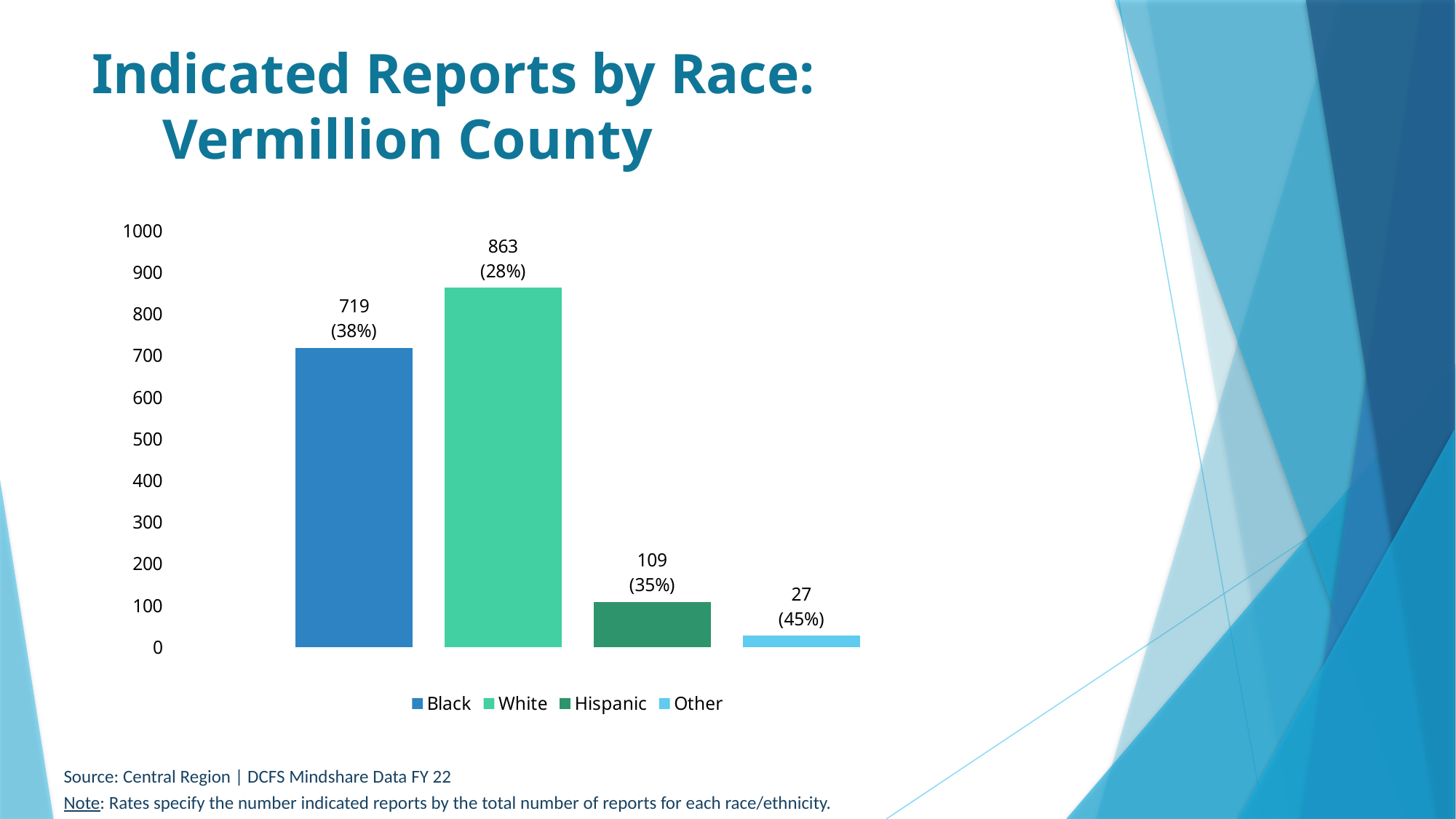
What is the number of indicated reports for Black? 719 What is the title of the chart on the slide? Indicated Reports by Race: Vermillion County What kind of chart is shown on the slide? Bar chart Which category has the highest number of indicated reports? White Is the value for Black greater or less than 600? greater Which has more indicated reports, Hispanic or Other? Hispanic Which category has the lowest number of indicated reports? Other What is the number of indicated reports for Hispanic? 109 What is the difference between the number of indicated reports for White and Black? 144 What percentage is shown for the Other category? 45% How many categories are shown in the chart? 4 What is the number of indicated reports for White? 863